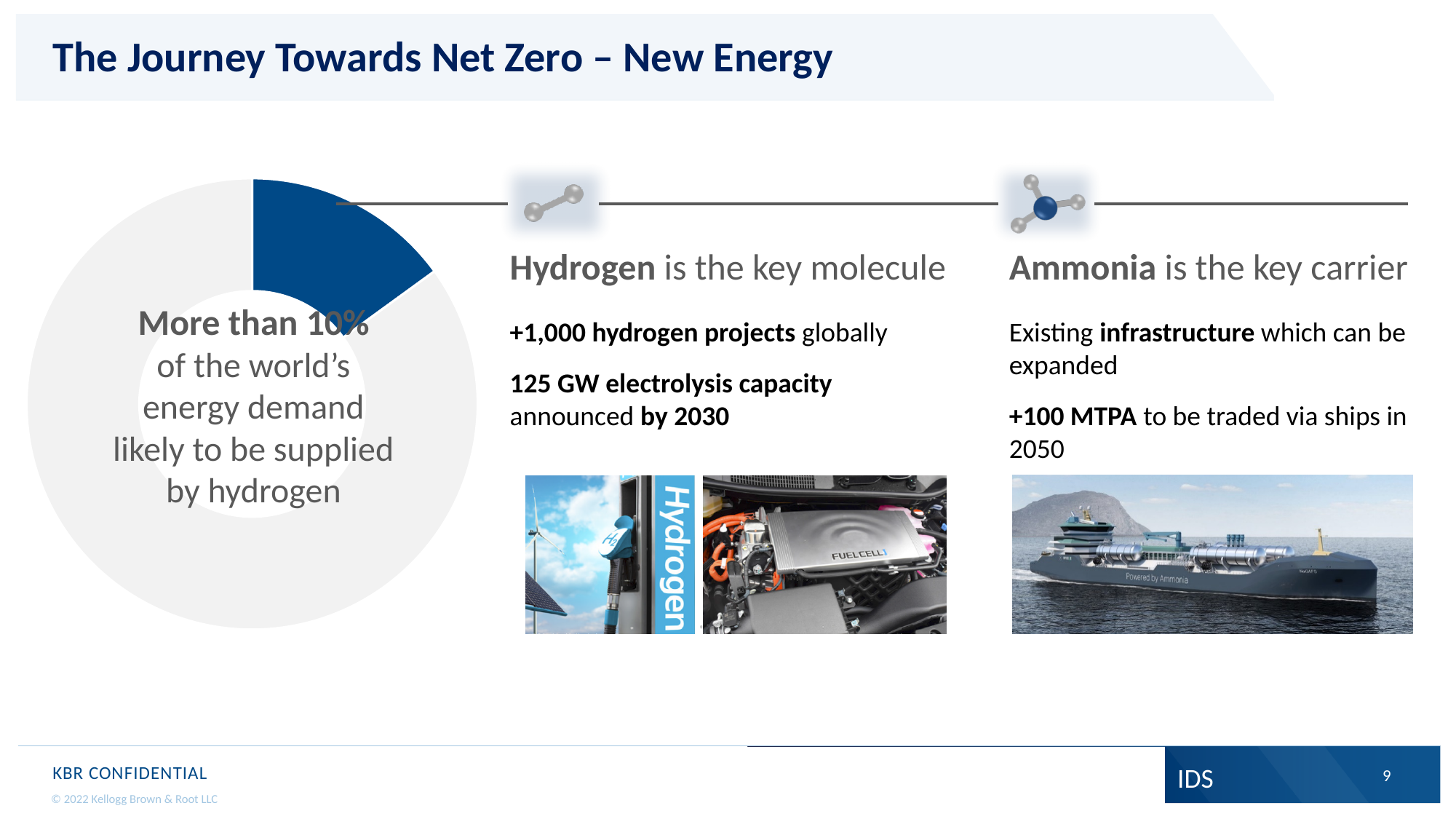
What colour is the slice representing hydrogen's share in the donut chart? Blue According to the text in the centre of the donut chart, what share of the world's energy demand is likely to be supplied by hydrogen? More than 10% Is the blue slice of the donut chart greater or less than half of the chart? less In the donut chart, which slice is larger, the blue slice or the grey slice? The grey slice What kind of chart is shown on the left of the slide? Pie (donut) chart What does the blue slice of the donut chart represent? The share of the world's energy demand likely to be supplied by hydrogen How many slices does the donut chart on the left have? 2